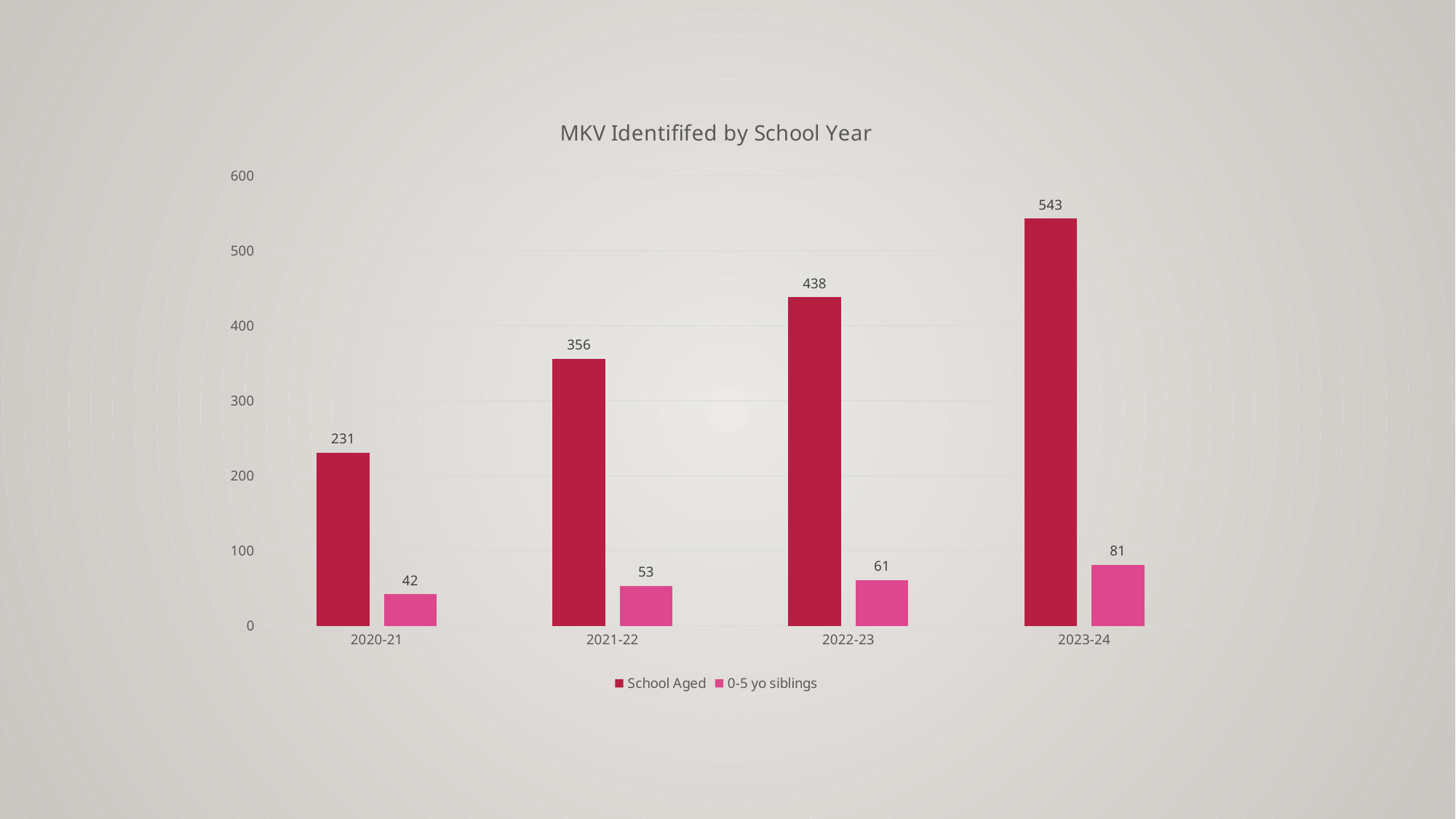
Is the School Aged value for 2022-23 greater or less than 400? greater What is the difference between the School Aged values for 2023-24 and 2022-23? 105 What kind of chart is shown on the slide? bar chart What is the 0-5 yo siblings value for 2023-24? 81 How many school years are shown on the x axis? 4 Which school year has the lowest 0-5 yo siblings value? 2020-21 Do the School Aged values rise or fall from 2020-21 to 2023-24? rise What is the School Aged value for 2021-22? 356 Which is larger: the 0-5 yo siblings value for 2021-22 or for 2022-23? 2022-23 Which school year has the highest School Aged value? 2023-24 How many series does the legend list? 2 What is the School Aged value for 2020-21? 231